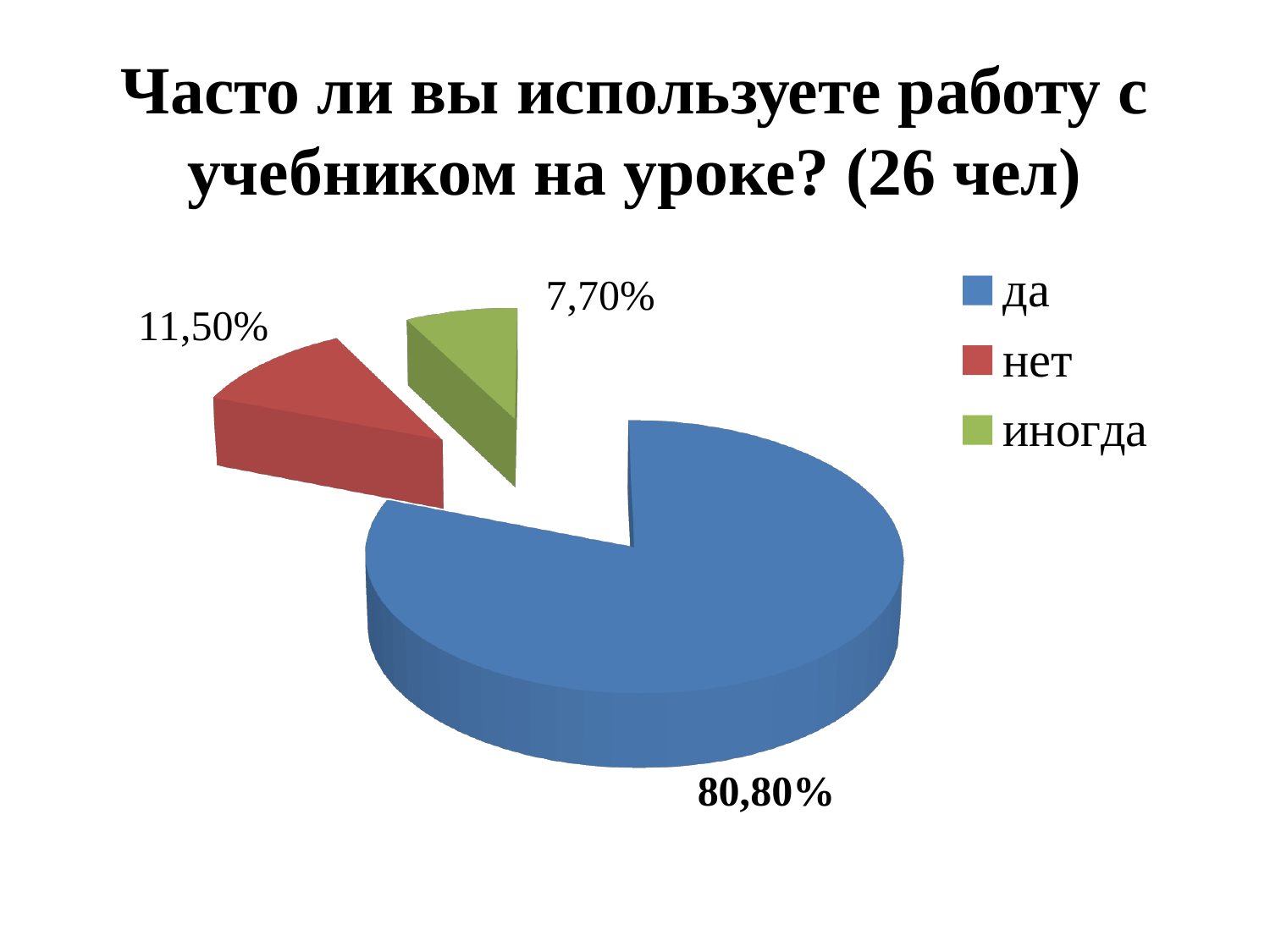
What kind of chart is shown on the slide? pie chart Which category has the smallest share of the pie? иногда How many categories does the pie chart show? 3 What is the title of the chart? Часто ли вы используете работу с учебником на уроке? (26 чел) What share of the pie does "иногда" represent? 7,70% What share of the pie does "нет" represent? 11,50% What share of the pie does "да" represent? 80,80% Which category has the largest share of the pie? да What is the difference between the shares for "да" and "нет"? 69,30% What colour is the slice for "иногда"? green Which is larger, the share for "нет" or the share for "иногда"? нет What is the difference between the shares for "нет" and "иногда"? 3,80%